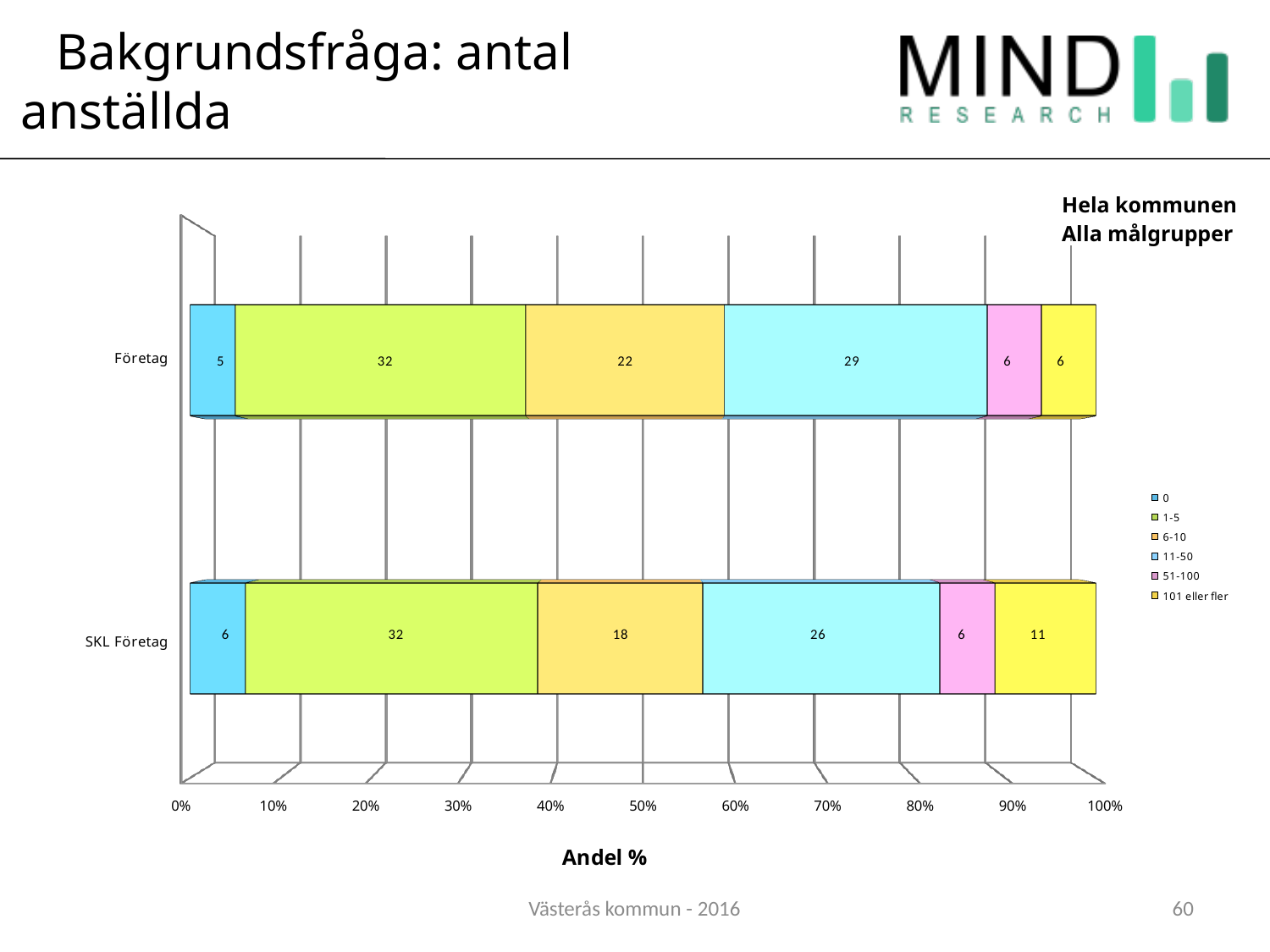
Which segment is the smallest in the Företag bar? 0 How many series does the legend list? 6 Which has a larger '101 eller fler' value, Företag or SKL Företag? SKL Företag Which segment is the largest in the Företag bar? 1-5 What is the label of the x axis? Andel % How many categories (bars) are shown on the chart? 2 What is the value of the '1-5' segment for Företag? 32 What is the value of the '6-10' segment for Företag? 22 What is the value of the '11-50' segment for SKL Företag? 26 What is the value of the '101 eller fler' segment for SKL Företag? 11 What is the difference between the '6-10' values for Företag and SKL Företag? 4 What kind of chart is shown on the slide? Stacked bar chart